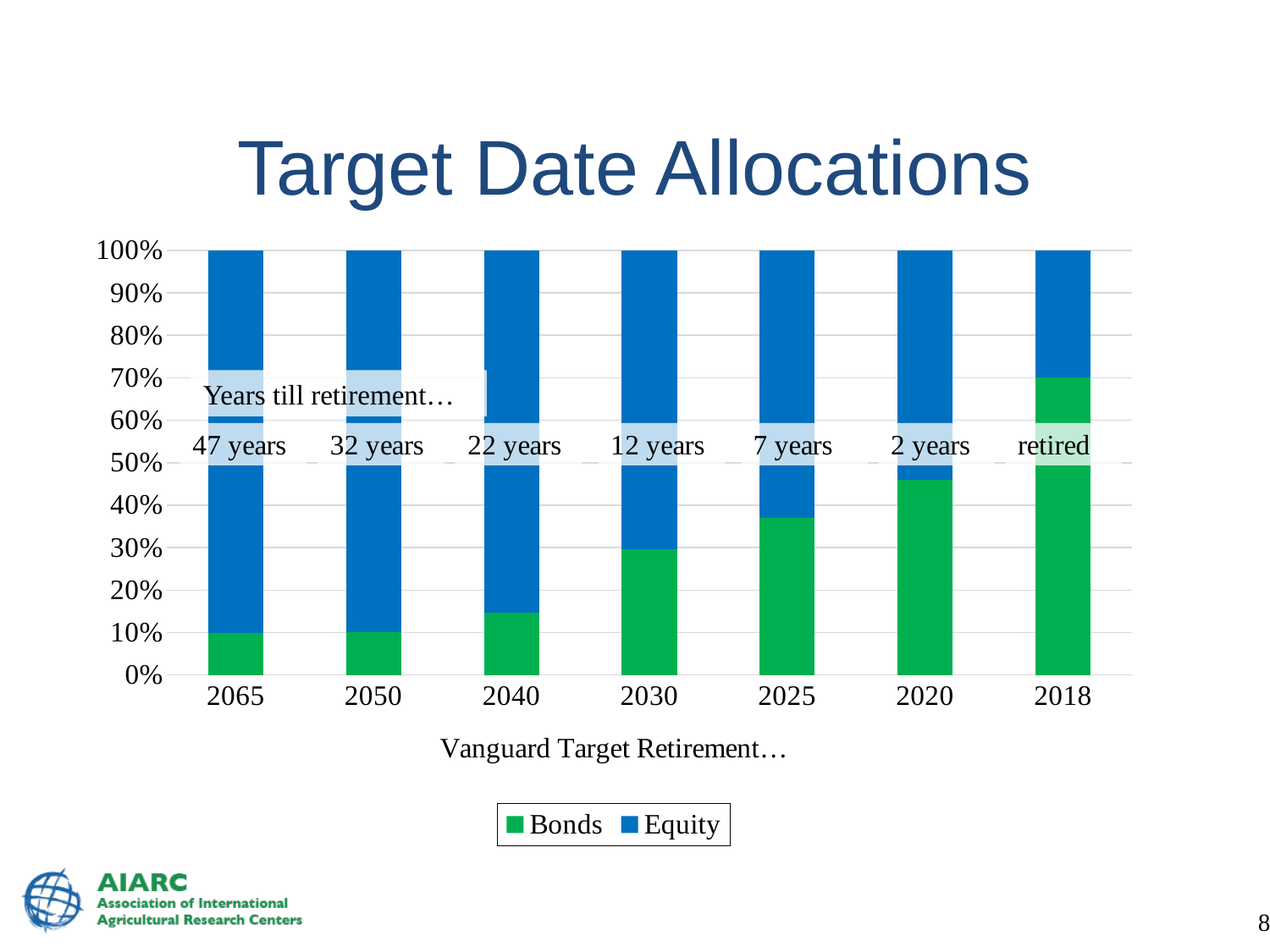
Which colour represents Equity in the chart? blue Which is larger, the Bonds share for 2030 or the Bonds share for 2050? 2030 Is the Bonds share for 2025 greater or less than 30%? greater Does the Bonds share rise or fall moving from 2065 to 2018 along the x axis? rise Is the Bonds share for 2040 greater or less than 20%? less How many series does the legend list? 2 What is the total height of each stacked bar? 100% Which category has the largest Bonds share? 2018 What kind of chart is shown on the slide? stacked bar chart How many target date funds (categories) are shown on the x axis? 7 Is the Bonds share for 2020 greater or less than 50%? less